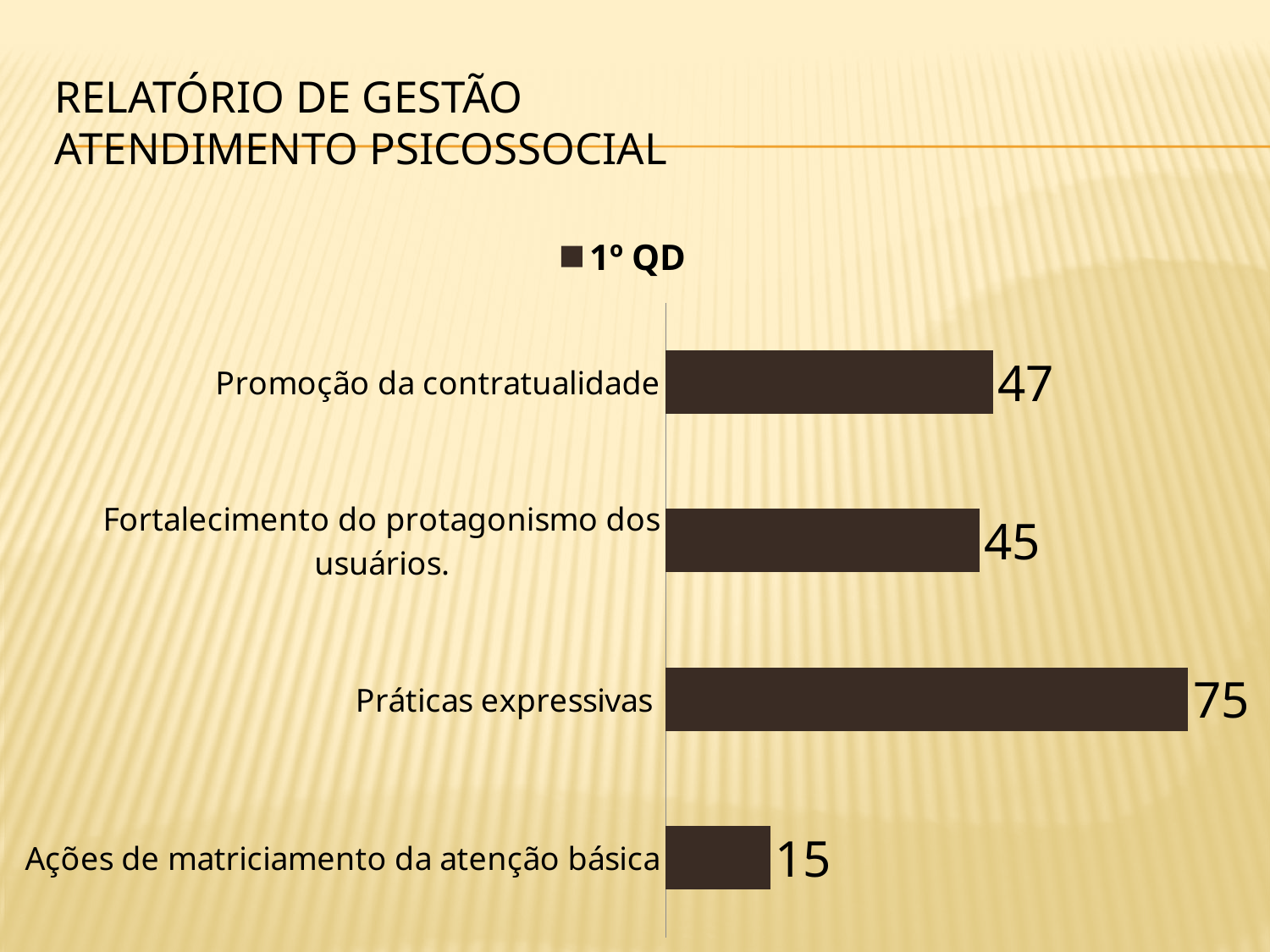
How many series does the legend list? 1 How many categories are shown in the chart? 4 What is the difference between the values for Promoção da contratualidade and Fortalecimento do protagonismo dos usuários? 2 Which category has the highest value? Práticas expressivas Which is larger: the value for Práticas expressivas or the value for Promoção da contratualidade? Práticas expressivas What is the value for Ações de matriciamento da atenção básica? 15 Which category has the lowest value? Ações de matriciamento da atenção básica What is the value for Práticas expressivas? 75 What is the value for Fortalecimento do protagonismo dos usuários? 45 What is the value for Promoção da contratualidade? 47 What is the difference between the values for Práticas expressivas and Ações de matriciamento da atenção básica? 60 What kind of chart is shown on the slide? Bar chart